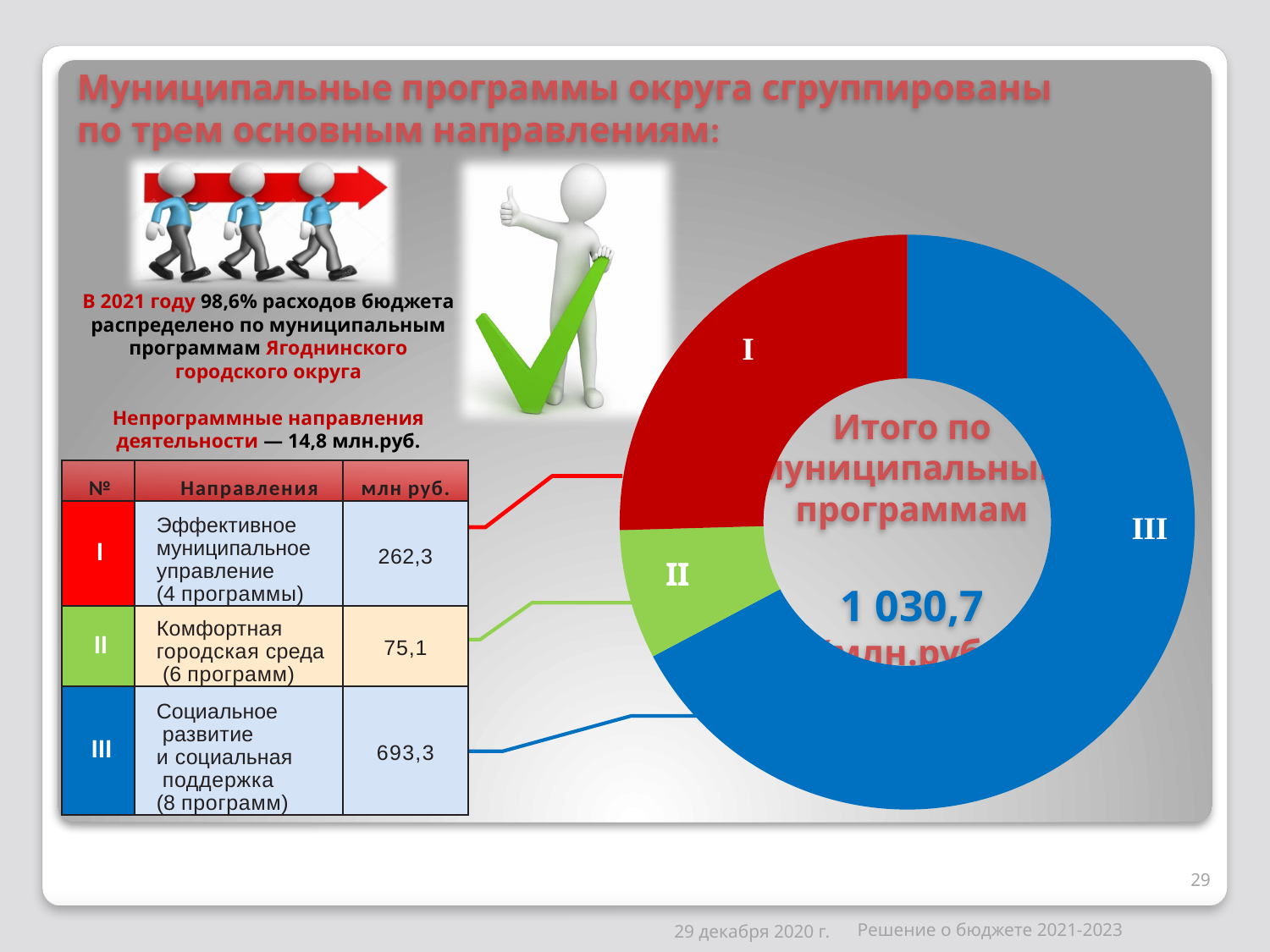
What is the value in млн руб. for segment I (Эффективное муниципальное управление)? 262,3 What is the value in млн руб. for segment II (Комфортная городская среда)? 75,1 What is the difference between the values for segment III and segment I, in млн руб.? 431,0 Which is larger, the value for segment I or the value for segment II? Segment I How many segments does the donut chart have? 3 What is the total for all municipal programmes shown in the centre of the donut chart? 1 030,7 млн.руб. What colour is segment III in the donut chart? Blue Which segment of the donut chart is the smallest? II What kind of chart is shown on the slide? Donut (pie) chart What is the value in млн руб. for segment III (Социальное развитие и социальная поддержка)? 693,3 Which segment of the donut chart is the largest? III What colour is segment II in the donut chart? Green